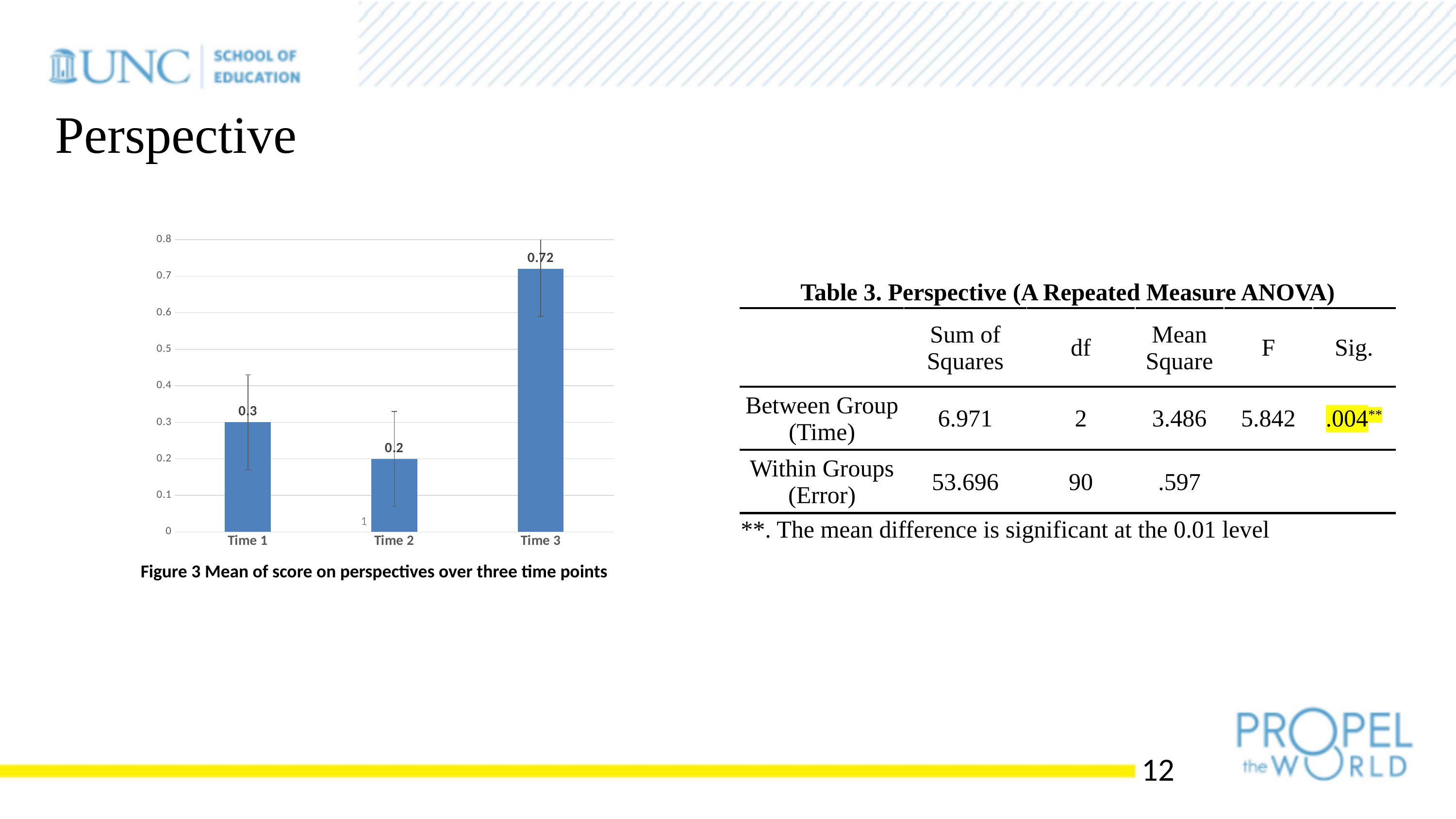
Is the value for Time 3 greater or less than 0.5? greater How many time points are shown on the chart? 3 What is the value for Time 2? 0.2 What is the value for Time 3? 0.72 What is the value for Time 1? 0.3 Which time point has the highest value? Time 3 What is the difference between the values for Time 1 and Time 2? 0.1 Which is larger, the value for Time 1 or the value for Time 2? Time 1 What kind of chart is shown on the slide? bar chart What is the difference between the values for Time 3 and Time 1? 0.42 What is the caption of the figure below the chart? Figure 3 Mean of score on perspectives over three time points Which time point has the lowest value? Time 2